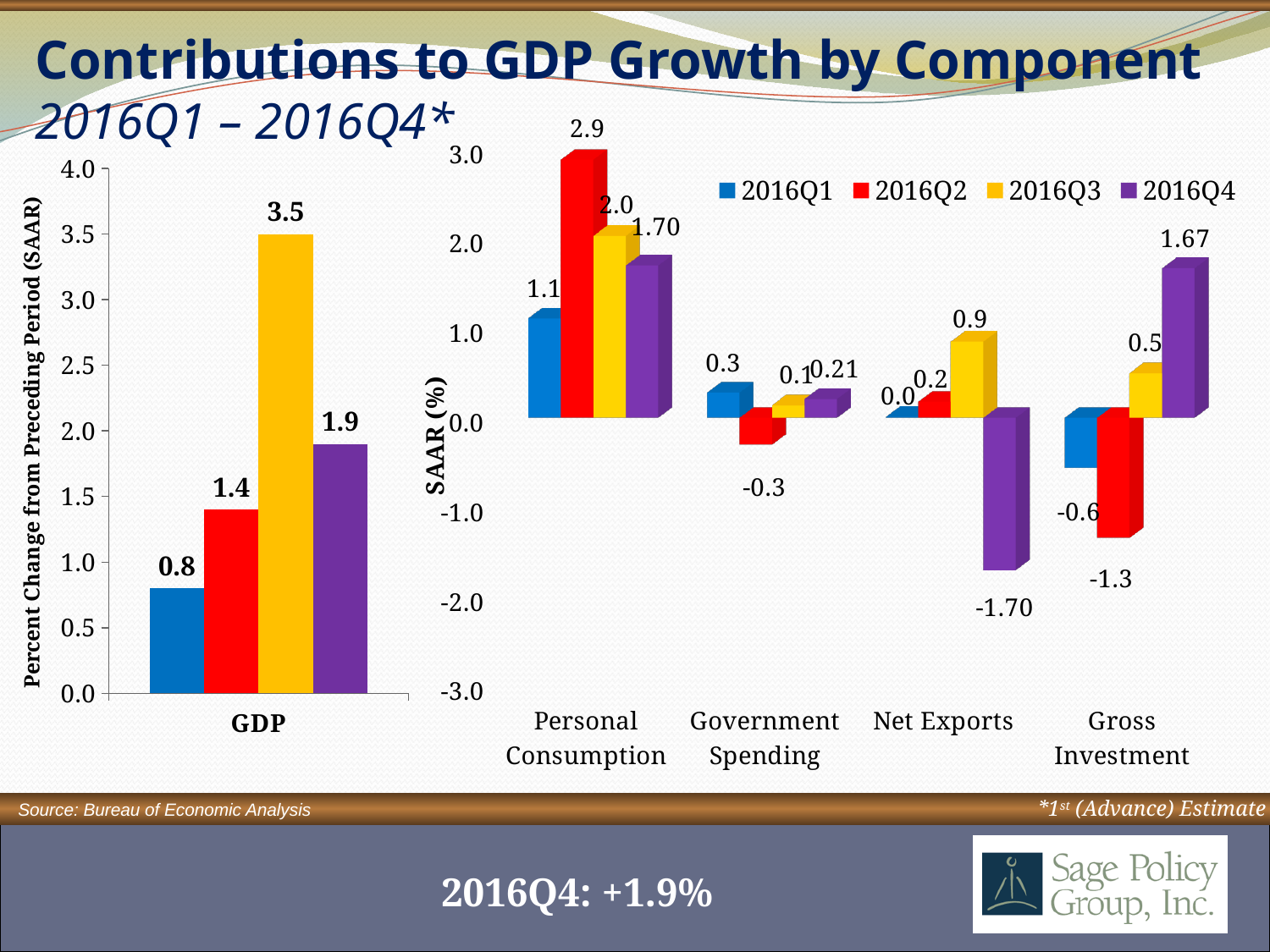
In the right chart, what is the value for 2016Q2 in Personal Consumption? 2.9 In the left chart (GDP), what is the lowest value shown? 0.8 What kind of chart is the right chart? Bar chart In the right chart, what is the value for 2016Q4 in Gross Investment? 1.67 In the right chart, what is the value for 2016Q4 in Net Exports? -1.70 In the left chart (GDP), how many bars are plotted? 4 In the left chart (GDP), what is the highest value shown? 3.5 In the right chart, which is larger for Government Spending: 2016Q1 or 2016Q3? 2016Q1 In the right chart, how many series does the legend list? 4 In the right chart, how many categories are shown on the x axis? 4 In the right chart, which series has the lowest value in Gross Investment? 2016Q2 In the left chart (GDP), what is the difference between the highest bar (3.5) and the lowest bar (0.8)? 2.7